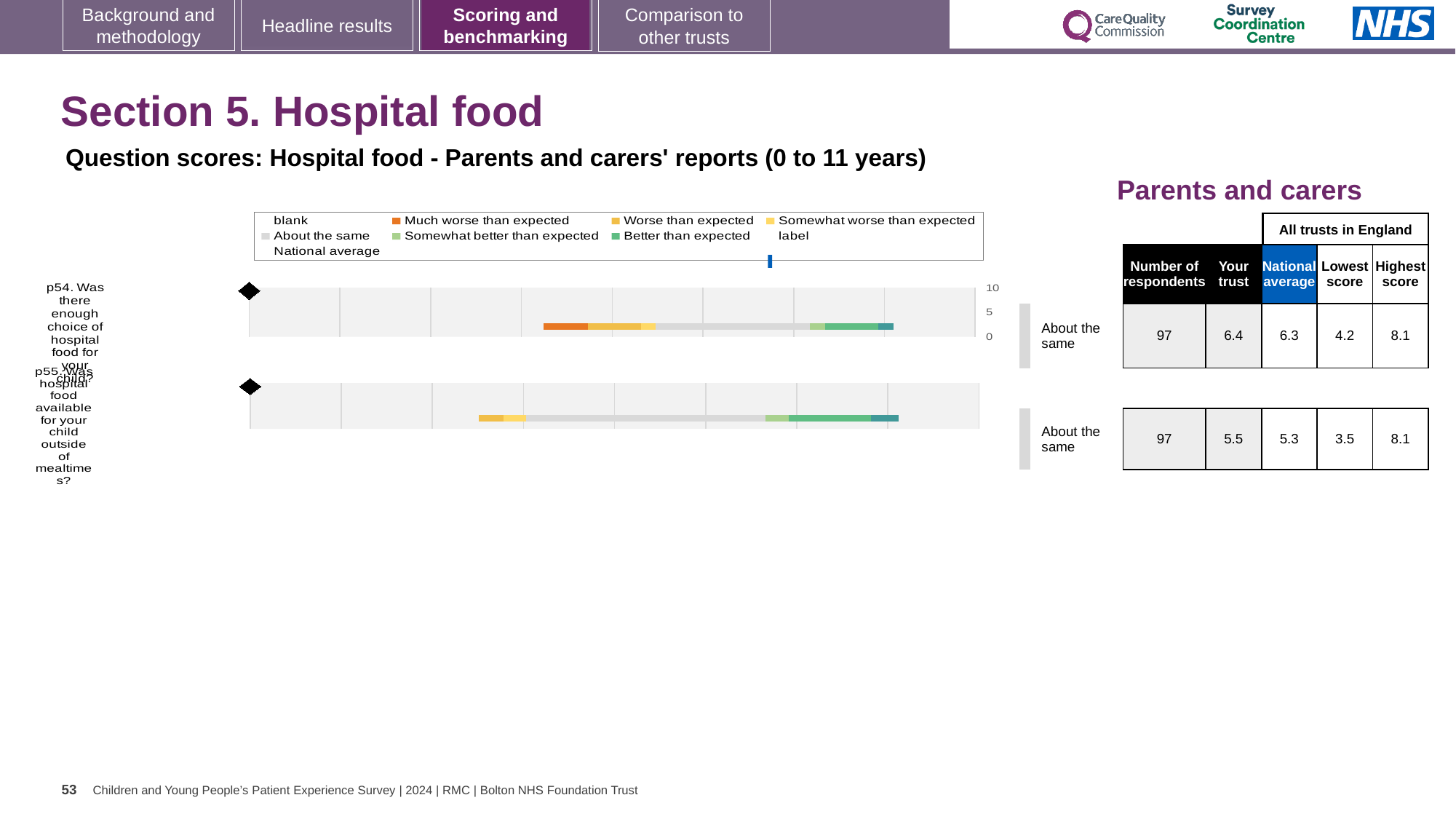
Which question has the higher 'Your trust' score, p54 or p55? p54 What is the maximum value shown on the score axis of the hospital food chart? 10 What is the lowest score across all trusts in England for p55? 3.5 What kind of chart is used to show the question scores for hospital food? bar chart What is the difference between the 'Your trust' score and the national average for p55? 0.2 What is the 'Your trust' score for p54 (enough choice of hospital food for your child)? 6.4 Which legend entry is shown in orange in the hospital food chart? Much worse than expected How many entries does the legend of the hospital food chart list? 9 What is the 'Your trust' score for p55 (hospital food available outside of mealtimes)? 5.5 How many respondents answered p54? 97 How many questions (categories) are plotted in the hospital food chart? 2 What is the national average score for p54? 6.3